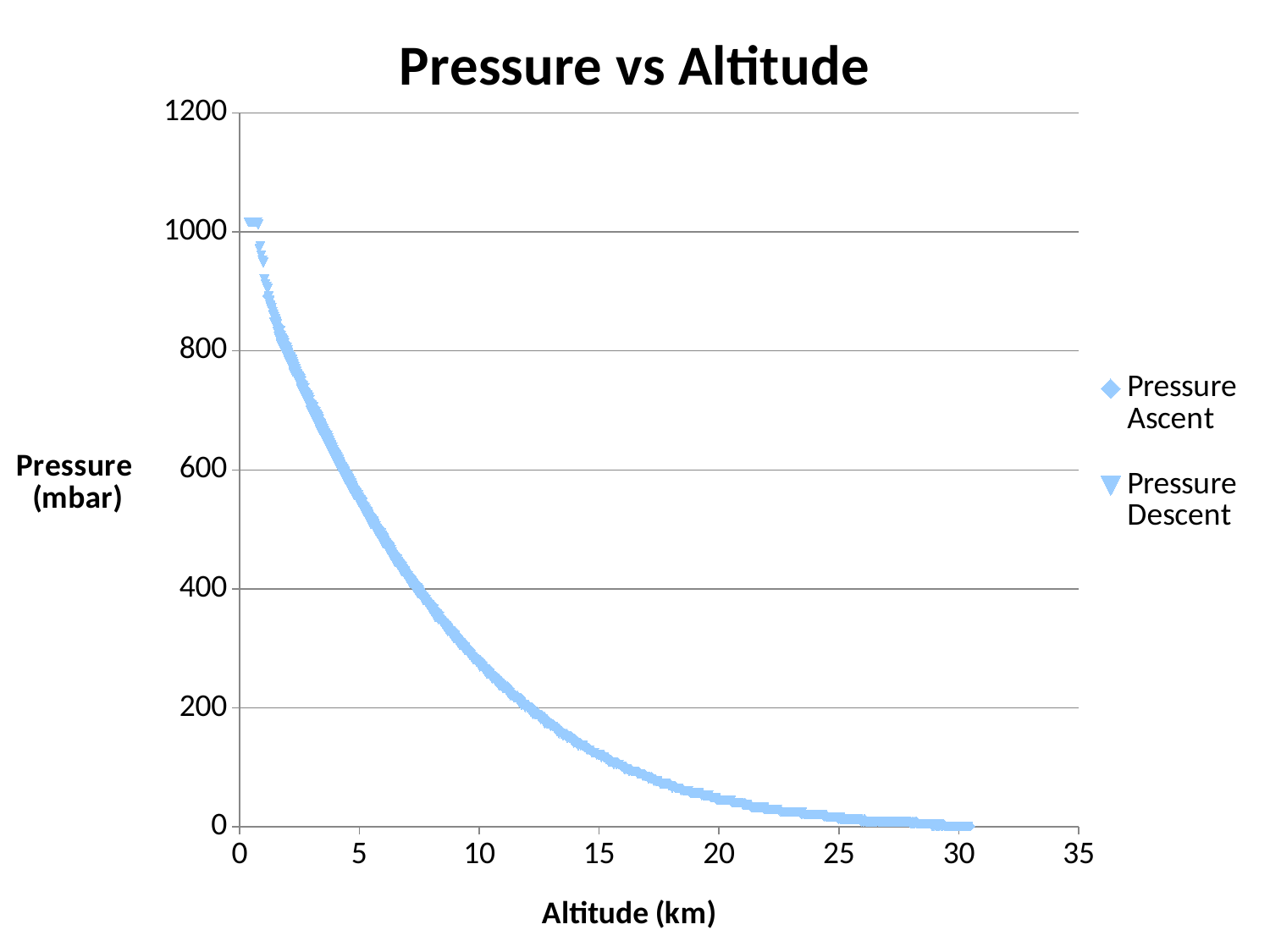
Is the pressure at an altitude of 20 km greater or less than 200 mbar? less Is the maximum altitude reached by the plotted points greater or less than 25 km? greater Is the highest pressure plotted greater or less than 1000 mbar? greater What are the two series named in the legend? Pressure Ascent and Pressure Descent What is the title of the chart? Pressure vs Altitude Do the pressure values rise or fall as altitude increases along the x axis? fall How many series does the legend list? 2 What kind of chart is shown on the slide? scatter chart